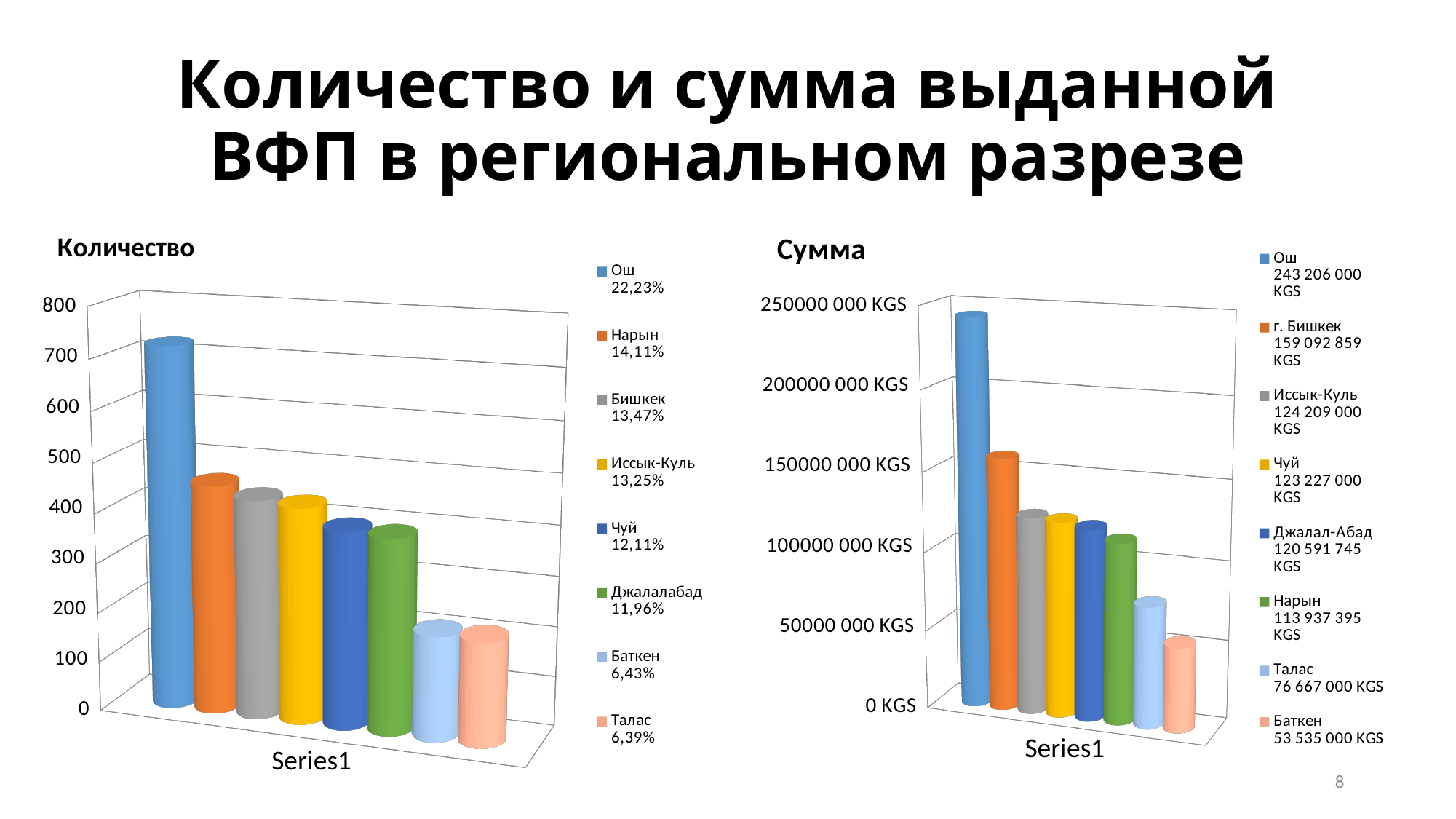
In the "Количество" chart, what percentage is shown for Ош in the legend? 22,23% In the "Сумма" chart, which region has the highest value? Ош In the "Сумма" chart, which is larger: the value for Талас or the value for Баткен? Талас What kind of chart is the "Количество" chart? bar chart In the "Количество" chart, what percentage is shown for Баткен in the legend? 6,43% In the "Сумма" chart, how many regions are listed in the legend? 8 In the "Сумма" chart, what is the difference between the values for Ош and Баткен? 189 671 000 KGS In the "Сумма" chart, which region has the lowest value? Баткен In the "Сумма" chart, what is the value for Талас? 76 667 000 KGS In the "Сумма" chart, what is the value for Ош? 243 206 000 KGS In the "Количество" chart, is the value for Ош greater or less than 500? greater In the "Количество" chart, is the value for Талас greater or less than 300? less